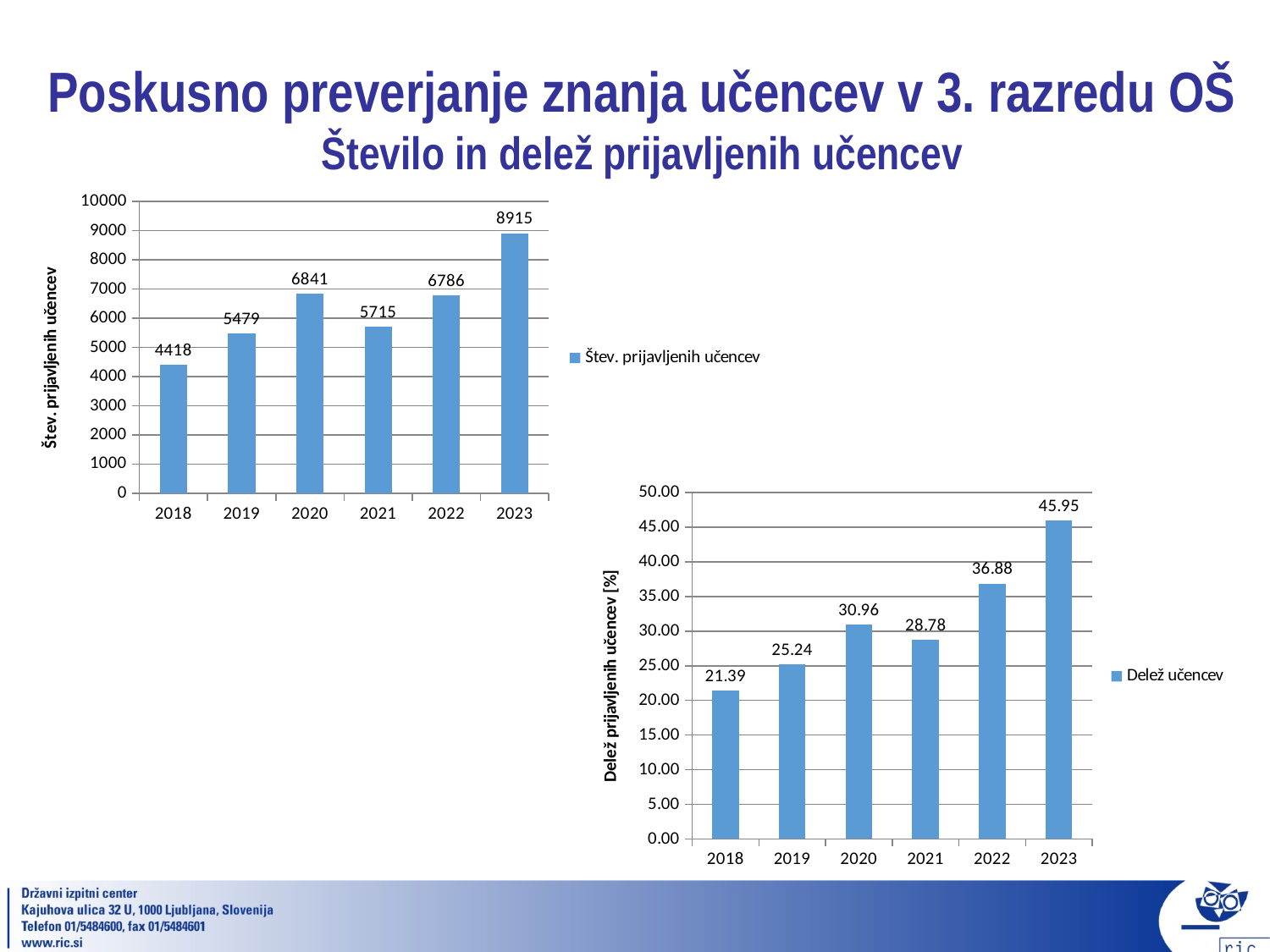
In the bottom-right chart (Delež učencev), what is the difference between the values for 2020 and 2021? 2.18 In the bottom-right chart (Delež učencev), how many series does the legend list? 1 In the top-left chart (Štev. prijavljenih učencev), how many years are shown on the x axis? 6 In the bottom-right chart (Delež učencev), what is the value for 2022? 36.88 In the top-left chart (Štev. prijavljenih učencev), which is larger, the value for 2020 or the value for 2021? 2020 In the top-left chart (Štev. prijavljenih učencev), what is the difference between the values for 2023 and 2022? 2129 In the top-left chart (Štev. prijavljenih učencev), which year has the lowest value? 2018 In the bottom-right chart (Delež učencev), what is the value for 2019? 25.24 In the top-left chart (Štev. prijavljenih učencev), which year has the highest value? 2023 In the top-left chart (Štev. prijavljenih učencev), what is the value for 2018? 4418 What kind of chart is the top-left chart (Štev. prijavljenih učencev)? bar chart In the bottom-right chart (Delež učencev), which year has the highest value? 2023